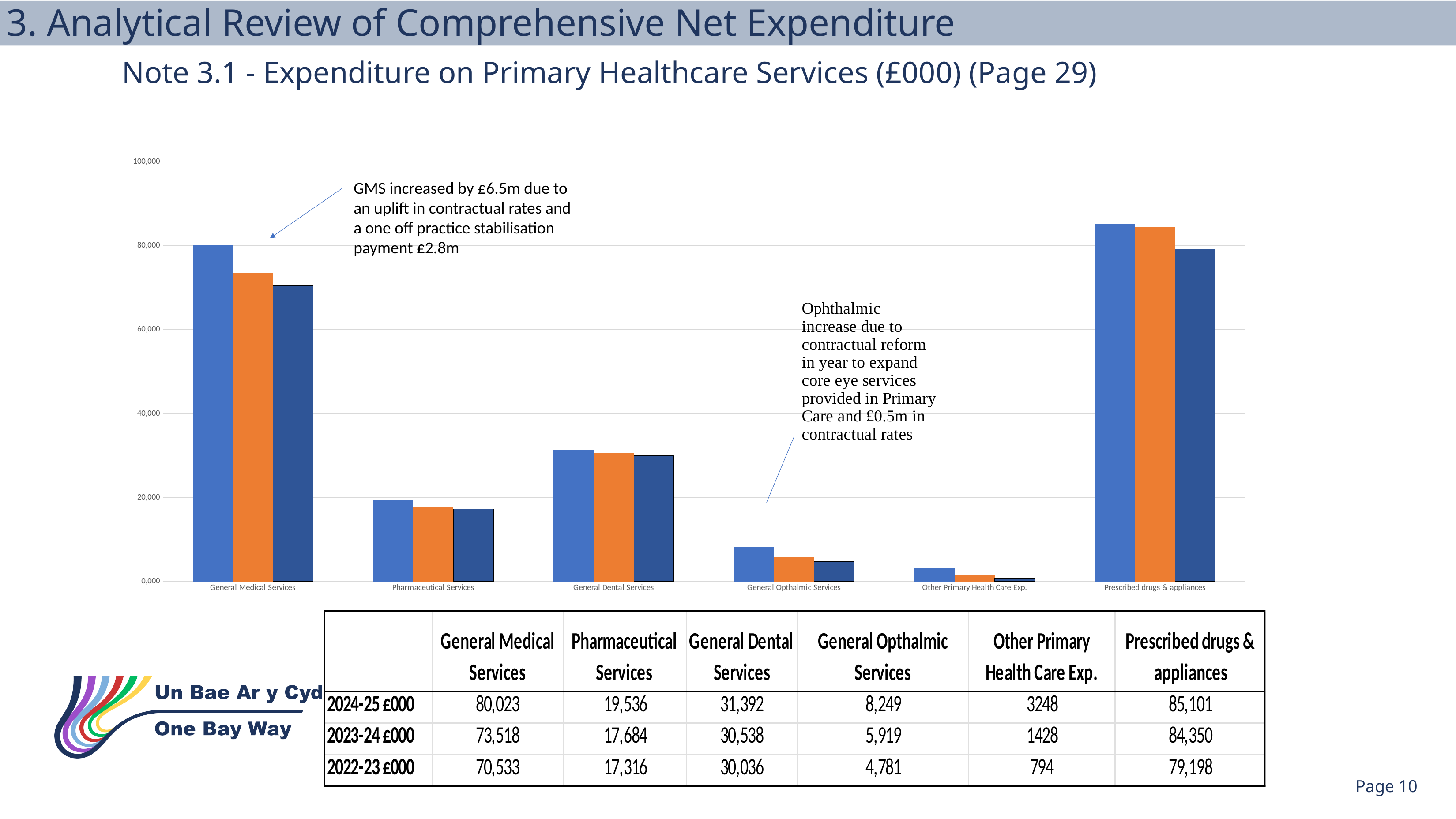
What kind of chart is shown on the slide? Bar chart Which was larger in 2024-25: expenditure on Pharmaceutical Services or General Dental Services? General Dental Services What was the expenditure on General Opthalmic Services in 2023-24 (£000)? 5,919 Which category had the lowest expenditure in 2024-25? Other Primary Health Care Exp. By how much did General Medical Services expenditure increase from 2023-24 to 2024-25 (£000)? 6,505 How many expenditure categories are shown on the x axis of the chart? 6 How many financial years are plotted as series in the chart? 3 What was the expenditure on Prescribed drugs & appliances in 2022-23 (£000)? 79,198 What is the difference between General Opthalmic Services expenditure in 2024-25 and 2023-24 (£000)? 2,330 Is the 2024-25 value for General Dental Services greater or less than 20,000? greater What was the expenditure on General Medical Services in 2024-25 (£000)? 80,023 Which category had the highest expenditure in 2024-25? Prescribed drugs & appliances